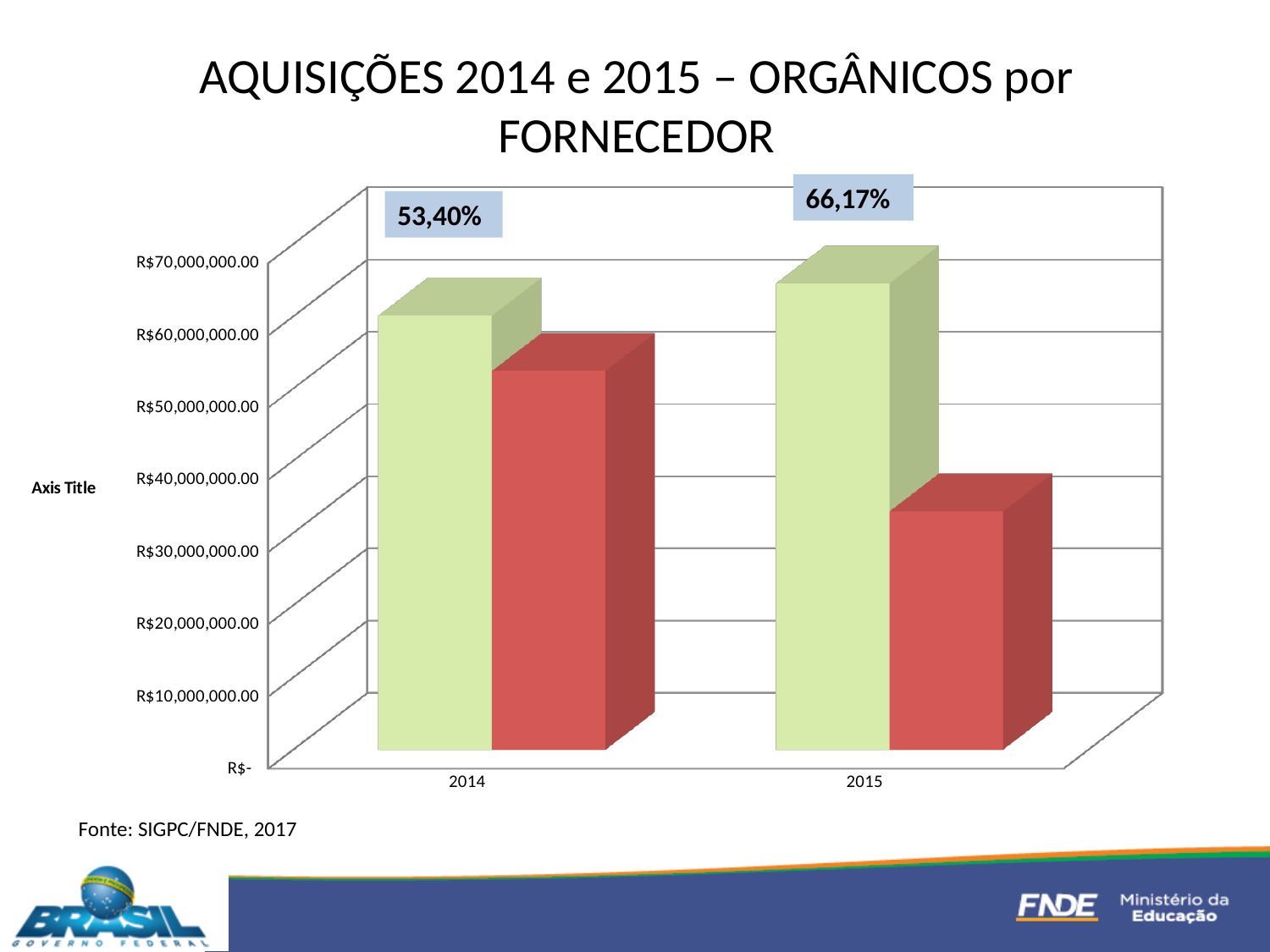
Which year has the higher percentage label, 2014 or 2015? 2015 Does the red series rise or fall from 2014 to 2015? fall What percentage label is shown above the 2014 bars? 53,40% Does the green series rise or fall from 2014 to 2015? rise What percentage label is shown above the 2015 bars? 66,17% In 2015, which bar is taller, the green bar or the red bar? the green bar Is the value of the red bar for 2015 greater or less than R$50,000,000.00? less How many categories are shown on the x axis of the chart? 2 Is the value of the green bar for 2014 greater or less than R$50,000,000.00? greater What kind of chart is shown on the slide? bar chart Is the value of the green bar for 2015 greater or less than R$60,000,000.00? greater What is the title of the chart on the slide? AQUISIÇÕES 2014 e 2015 – ORGÂNICOS por FORNECEDOR